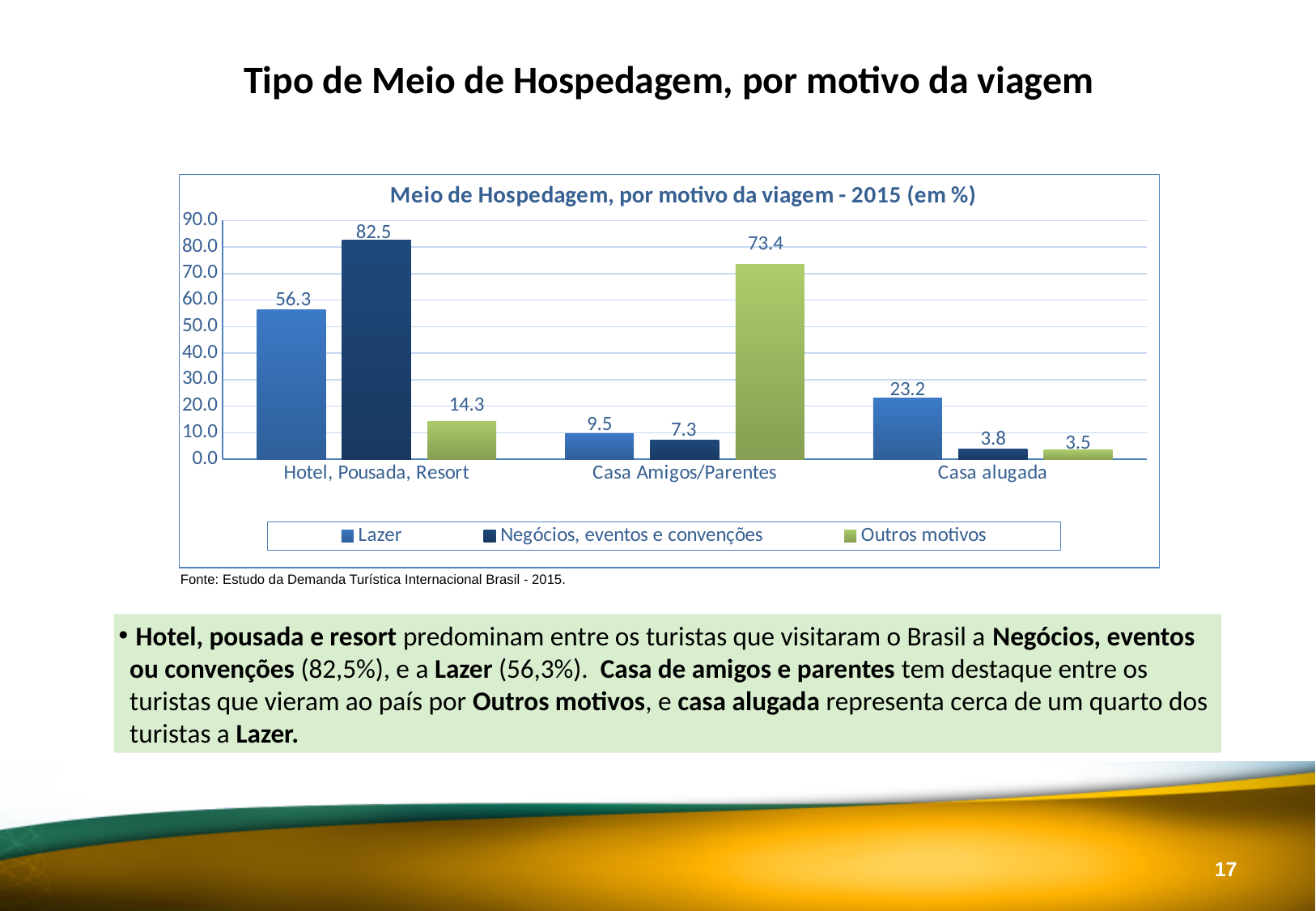
Is the value for Outros motivos in the Casa Amigos/Parentes category greater or less than 70.0? greater Which category has the highest value for the Outros motivos series? Casa Amigos/Parentes In the Casa alugada category, which series has the larger value: Lazer or Negócios, eventos e convenções? Lazer What is the value for Negócios, eventos e convenções in the Casa Amigos/Parentes category? 7.3 How many categories are shown on the x axis? 3 How many series does the legend list? 3 Which category has the lowest value for the Negócios, eventos e convenções series? Casa alugada What is the difference between the Negócios, eventos e convenções and Lazer values in the Hotel, Pousada, Resort category? 26.2 What is the value for Outros motivos in the Casa alugada category? 3.5 What is the title of the chart? Meio de Hospedagem, por motivo da viagem - 2015 (em %) What is the value for Lazer in the Hotel, Pousada, Resort category? 56.3 What kind of chart is shown on the slide? Bar chart